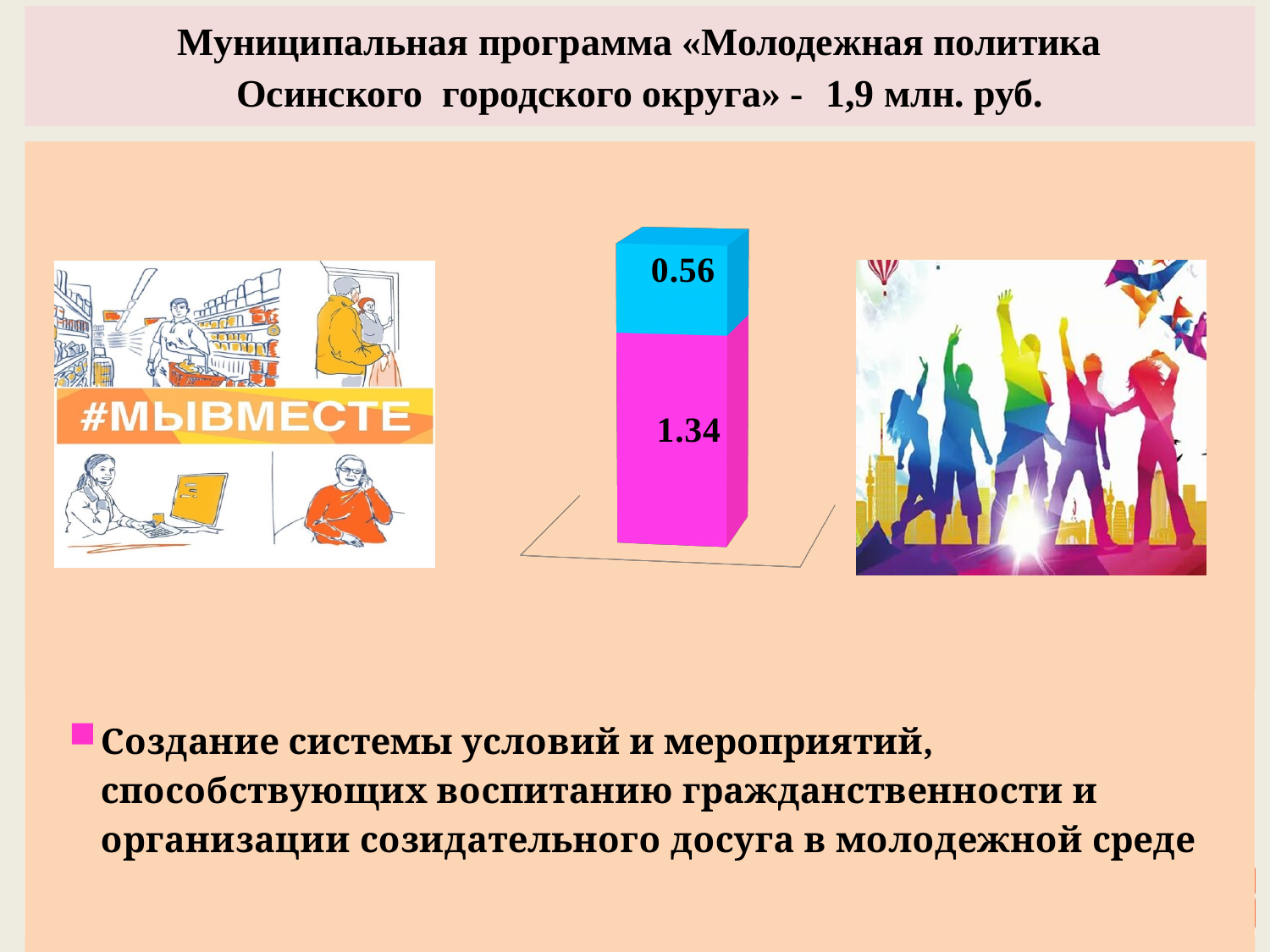
Which segment of the bar has the larger value, the magenta one or the blue one? magenta What is the difference between the magenta segment value and the blue segment value? 0.78 How many segments make up the stacked bar? 2 What type of chart is shown on the slide? bar chart Which segment of the bar has the smallest value? the blue segment (0.56) What colour is the segment at the top of the bar? blue What value is printed on the magenta (lower) segment of the bar? 1.34 Which segment of the bar has the largest value? the magenta segment (1.34) Is the value of the magenta segment greater or less than 1? greater How many bars does the chart contain? 1 What value is printed on the blue (upper) segment of the bar? 0.56 What is the total of the two segments in the stacked bar? 1.9